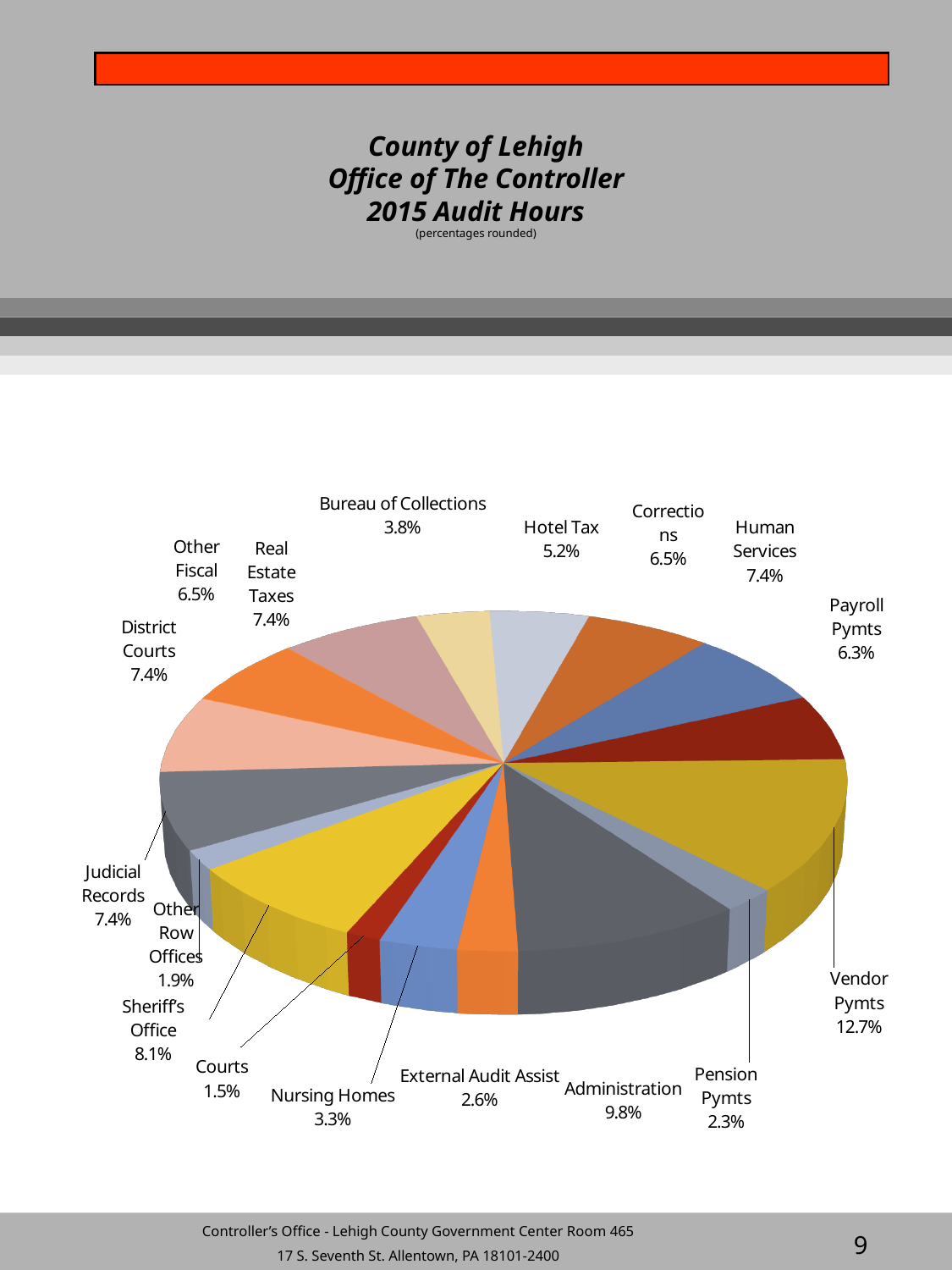
Which has a larger share, Hotel Tax or Corrections? Corrections What is the combined percentage of Pension Pymts and Payroll Pymts? 8.6% What percentage of audit hours is shown for Administration? 9.8% What percentage is shown for Bureau of Collections? 3.8% What kind of chart is shown on the slide? Pie chart What percentage of 2015 audit hours went to Vendor Pymts? 12.7% Which category has the smallest share of audit hours? Courts What is the title of the chart? County of Lehigh Office of The Controller 2015 Audit Hours How many categories are shown in the pie chart? 17 What is the percentage for Sheriff's Office? 8.1% Which category has the largest share of audit hours? Vendor Pymts What is the difference in percentage points between Vendor Pymts and Administration? 2.9